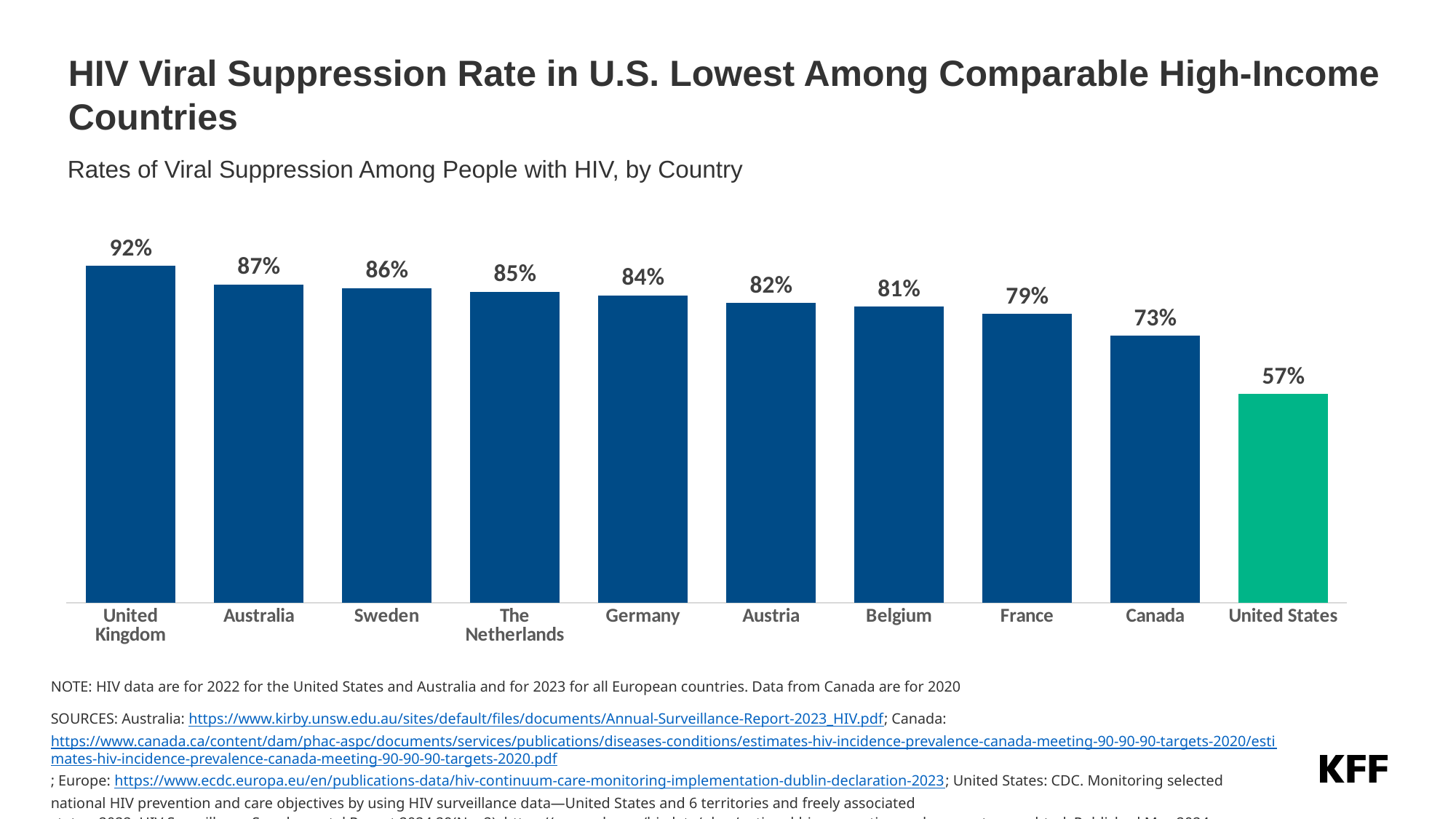
What is the difference between the viral suppression rates of Canada and the United States? 16% What is the viral suppression rate for Canada? 73% Which has a higher viral suppression rate, Germany or France? Germany Which country's bar is shown in a different colour (green) from the others? United States Do the values rise or fall moving from left to right across the chart? Fall Which country has the highest viral suppression rate? United Kingdom What is the viral suppression rate for the United States? 57% What is the viral suppression rate for the United Kingdom? 92% What kind of chart is shown on the slide? Bar chart Which country has the lowest viral suppression rate? United States How many countries are shown in the chart? 10 What is the difference between the viral suppression rates of the United Kingdom and the United States? 35%